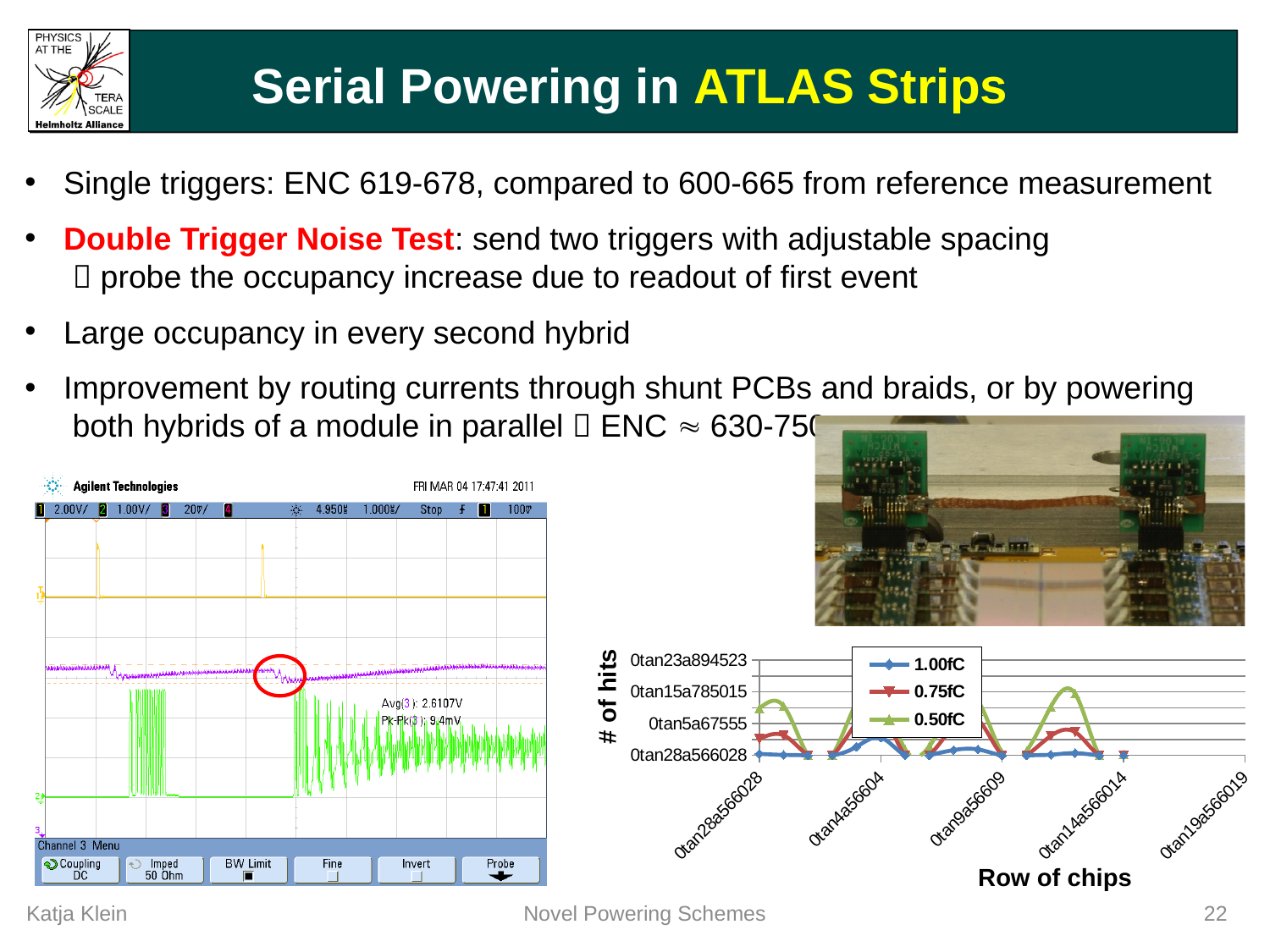
In the '# of hits' chart, which series reaches the highest peak values? 0.50fC In the '# of hits' chart, which series has higher peaks, 0.50fC or 0.75fC? 0.50fC What are the legend entries of the '# of hits' chart? 1.00fC, 0.75fC, 0.50fC In the '# of hits' chart, which series has higher peaks, 0.75fC or 1.00fC? 0.75fC How many series does the legend of the '# of hits' chart list? 3 In the '# of hits' chart, which series stays lowest across the rows of chips? 1.00fC What kind of chart is the '# of hits' vs 'Row of chips' chart at the bottom right of the slide? line chart What is the x-axis title of the '# of hits' chart? Row of chips